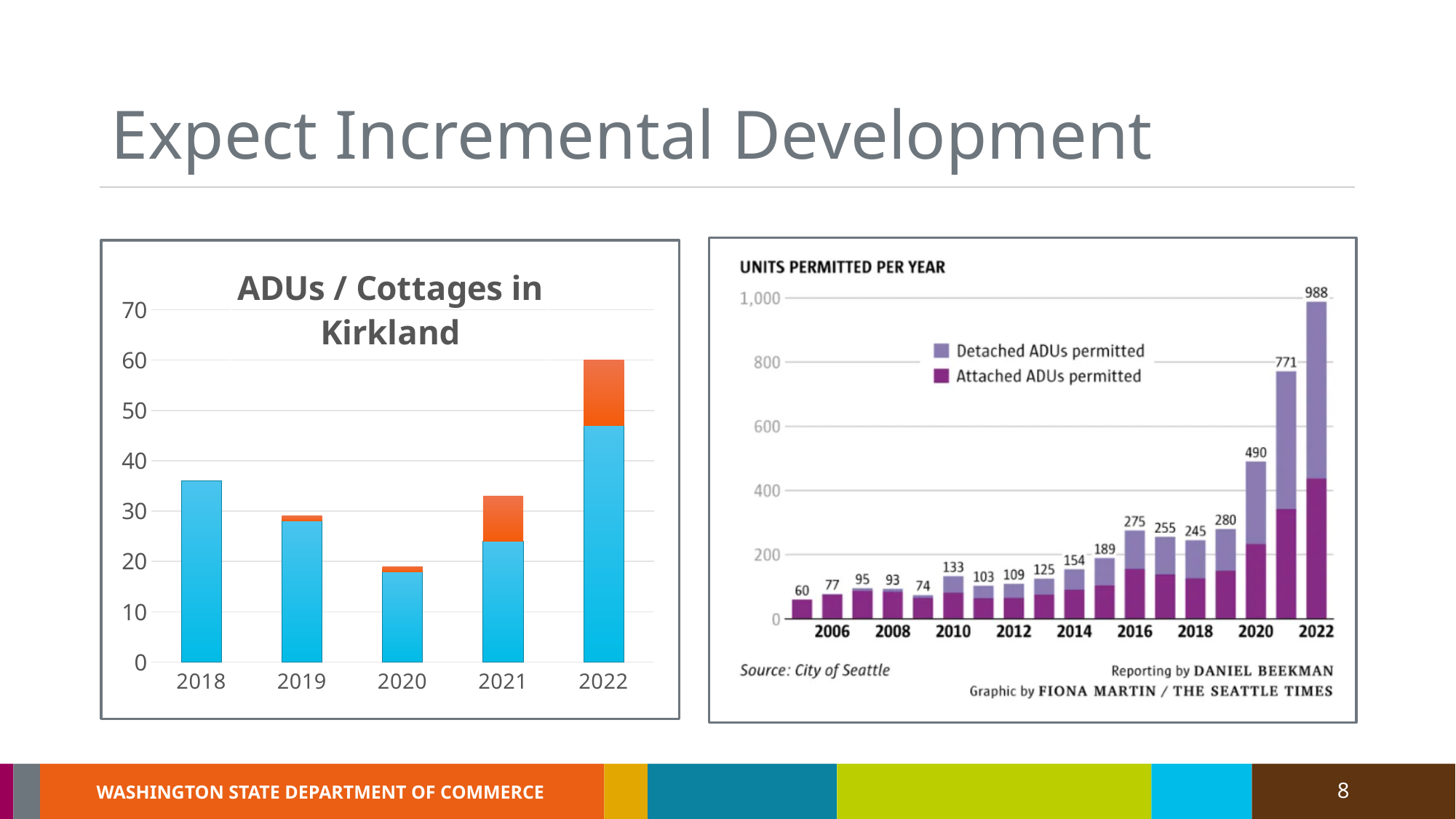
In the 'UNITS PERMITTED PER YEAR' chart, what is the total number of units permitted in 2016? 275 In the 'UNITS PERMITTED PER YEAR' chart, what is the total number of units permitted in 2020? 490 In the 'ADUs / Cottages in Kirkland' chart, is the total for 2018 greater or less than 30? greater In the 'ADUs / Cottages in Kirkland' chart, which year has the tallest bar? 2022 In the 'UNITS PERMITTED PER YEAR' chart, what is the difference between the totals for 2010 and 2006? 73 In the 'UNITS PERMITTED PER YEAR' chart, which year has the larger total, 2018 or 2014? 2018 In the 'UNITS PERMITTED PER YEAR' chart, what is the total number of units permitted in 2022? 988 In the 'UNITS PERMITTED PER YEAR' chart, which year has the highest total of units permitted? 2022 How many years are shown on the x axis of the 'ADUs / Cottages in Kirkland' chart? 5 In the 'UNITS PERMITTED PER YEAR' chart, what is the difference between the totals for 2022 and 2020? 498 In the 'ADUs / Cottages in Kirkland' chart, which year has the shortest bar? 2020 How many series does the legend of the 'UNITS PERMITTED PER YEAR' chart list? 2